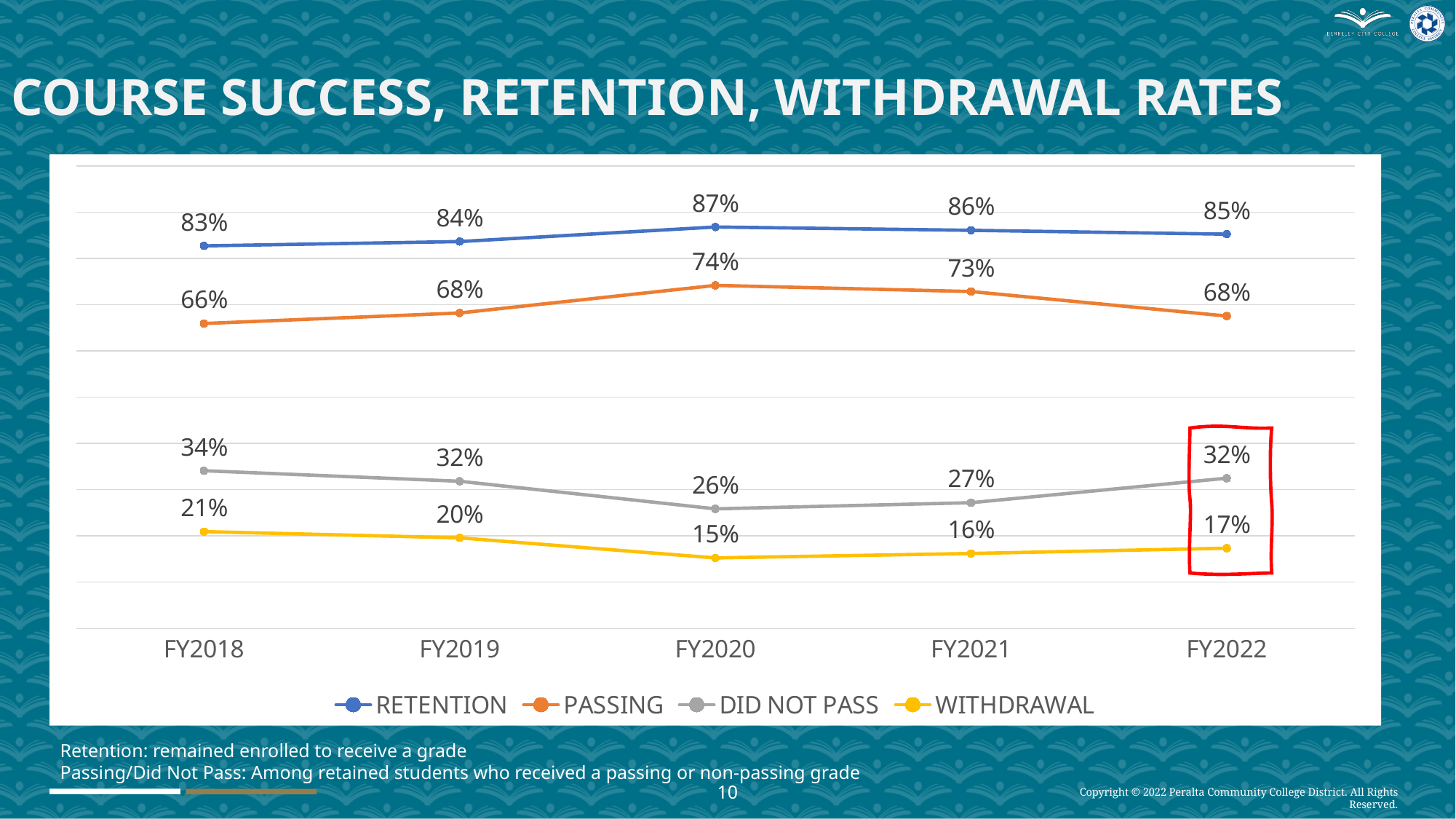
How many fiscal years are shown on the x axis? 5 What is the RETENTION rate for FY2020? 87% In which fiscal year is the RETENTION rate highest? FY2020 What is the PASSING rate for FY2018? 66% In which fiscal year is the WITHDRAWAL rate lowest? FY2020 Which is larger: the DID NOT PASS rate in FY2018 or in FY2022? FY2018 What is the WITHDRAWAL rate for FY2022? 17% What is the difference between the PASSING rate in FY2021 and FY2022? 5% Does the DID NOT PASS rate rise or fall from FY2020 to FY2022? Rise What kind of chart is shown on the slide? Line chart How many series does the legend list? 4 What is the DID NOT PASS rate for FY2021? 27%